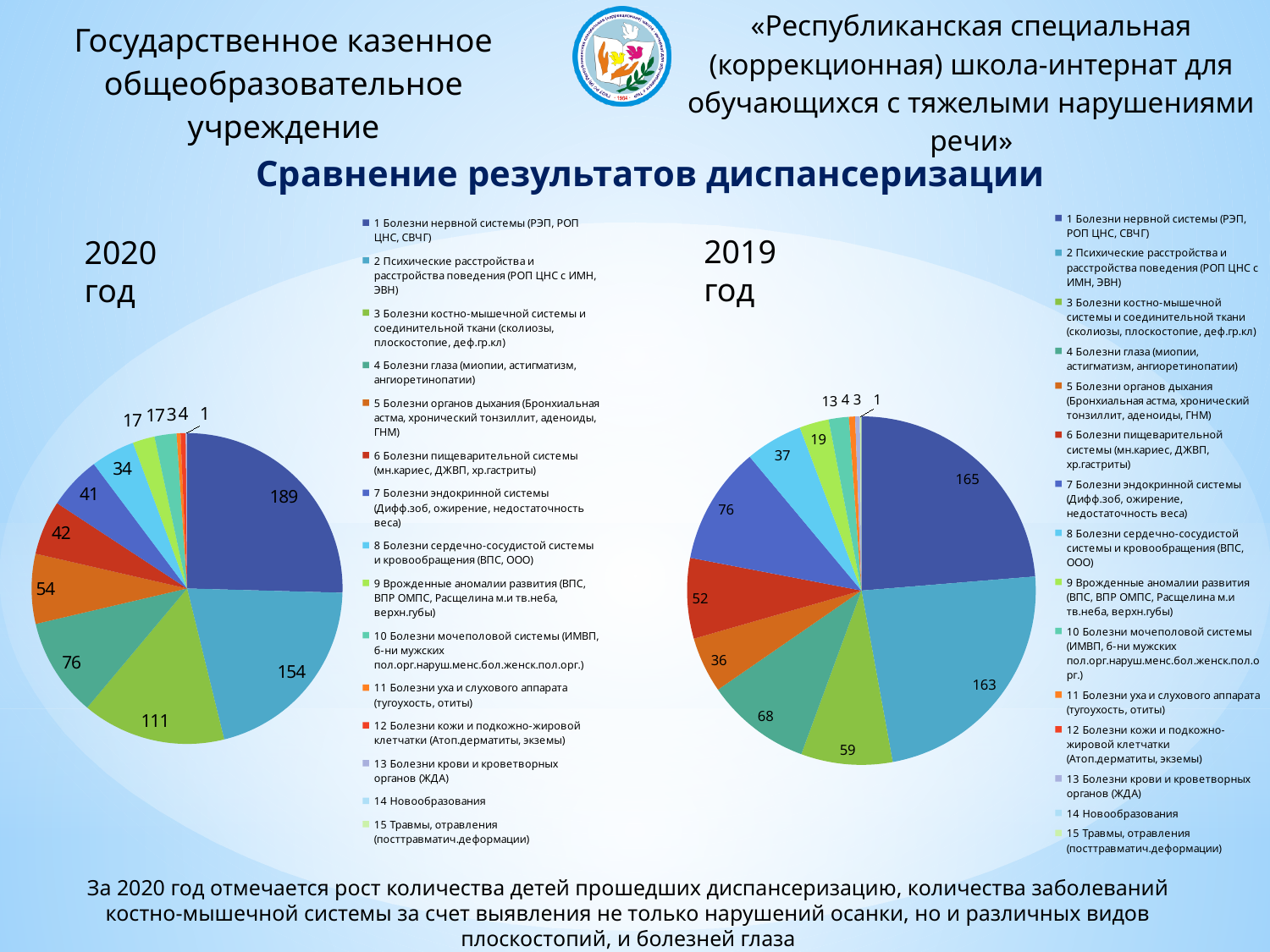
On the 2019 год pie chart, what is the value for 4 Болезни глаза? 68 How many categories does the legend of the 2020 год chart list? 15 What type of chart is used on this slide? Pie chart What is the title of the chart section on the slide? Сравнение результатов диспансеризации On the 2019 год pie chart, what is the value for 7 Болезни эндокринной системы? 76 On the 2019 год pie chart, what is the value for 2 Психические расстройства и расстройства поведения? 163 What is the difference between the 2020 год value (111) and the 2019 год value (59) for 3 Болезни костно-мышечной системы? 52 Which year has the larger value for 4 Болезни глаза, 2020 or 2019? 2020 On the 2020 год pie chart, what is the value for 1 Болезни нервной системы? 189 On the 2020 год pie chart, which category has the largest slice? 1 Болезни нервной системы On the 2020 год pie chart, what is the difference between 1 Болезни нервной системы (189) and 2 Психические расстройства (154)? 35 On the 2020 год pie chart, what is the value for 5 Болезни органов дыхания? 54